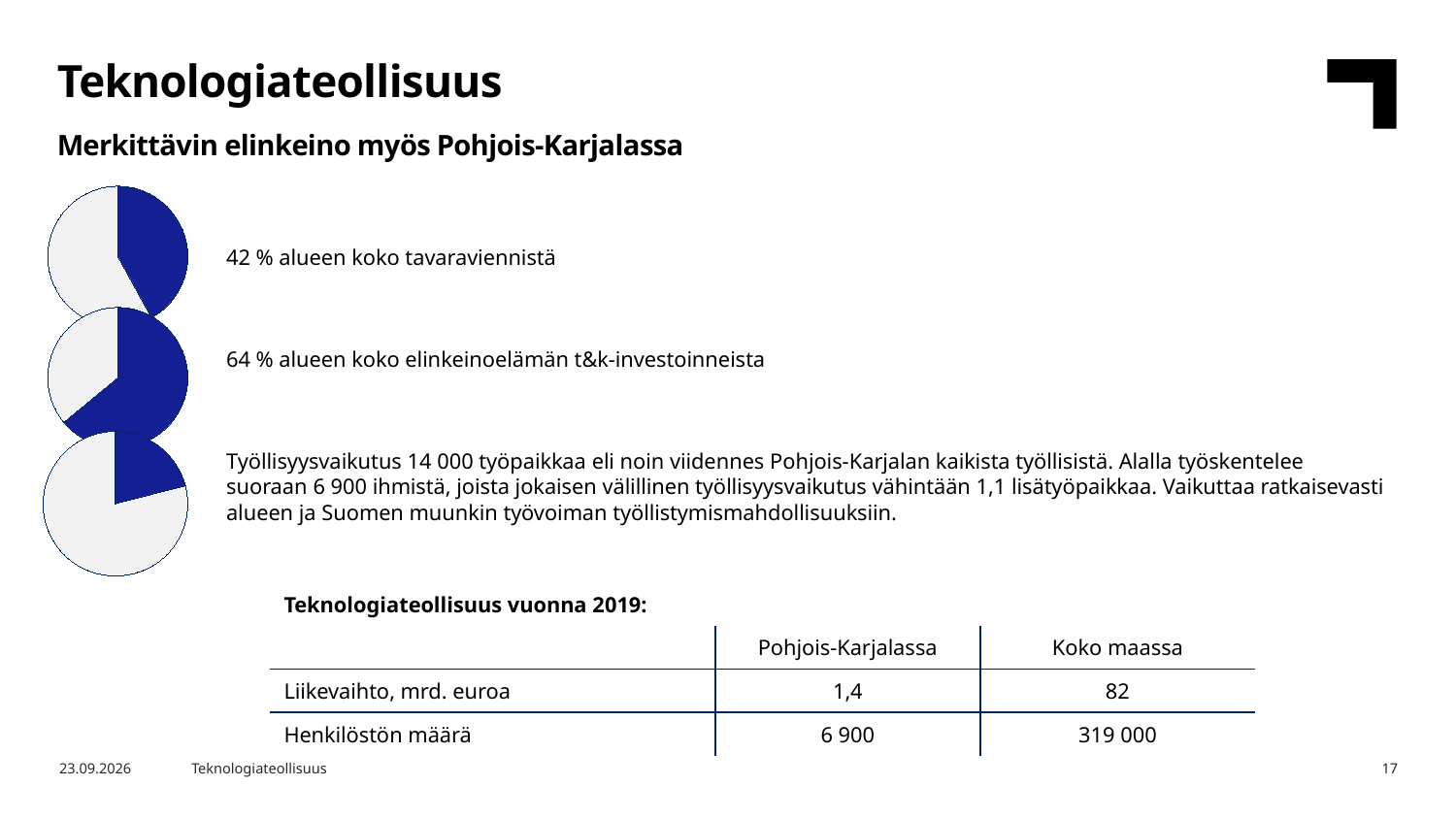
What colour is the highlighted slice in each pie chart? Blue Which pie chart has the largest blue slice: the top, middle or bottom one? Middle In the middle pie chart, what share of the region's business R&D investments (t&k-investoinnit) does the blue slice represent? 64 % Is the blue slice in the bottom pie chart greater or less than half of the pie? Less How many slices does each pie chart have? 2 In the top pie chart, what share of the region's total goods exports (tavaravienti) does the blue slice represent? 42 % Is the blue slice larger in the top pie chart (goods exports) or the middle pie chart (R&D investments)? Middle pie chart (R&D investments) Is the blue slice in the middle pie chart greater or less than half of the pie? Greater By how many percentage points does the R&D investment share (middle pie) exceed the goods export share (top pie)? 22 percentage points What kind of charts are shown on the left side of the slide? Pie charts Which pie chart has the smallest blue slice: the top, middle or bottom one? Bottom How many pie charts are on the slide? 3